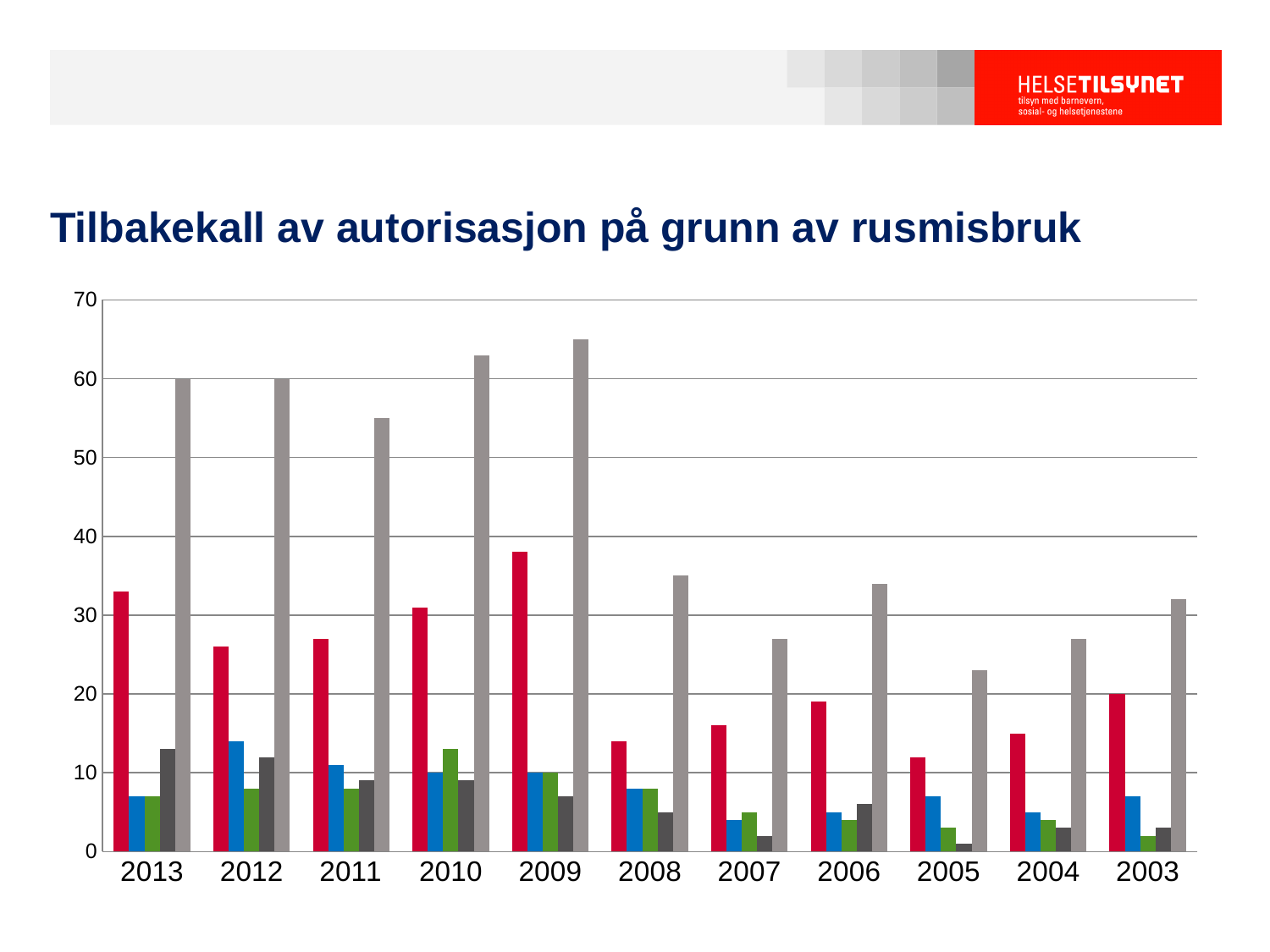
How many years are shown along the x axis? 11 What is the title of the chart? Tilbakekall av autorisasjon på grunn av rusmisbruk Which is larger, the red bar for 2013 or the red bar for 2012? 2013 What is the value of the light grey bar for 2013? 60 Is the red bar for 2013 greater or less than 30? greater Which year has the tallest red bar? 2009 Is the light grey bar for 2011 greater or less than 50? greater Is the light grey bar for 2007 greater or less than 30? less What kind of chart is shown on the slide? bar chart Which is larger, the light grey bar for 2006 or the light grey bar for 2005? 2006 How many bars are plotted for each year? 5 What is the value of the red bar for 2003? 20